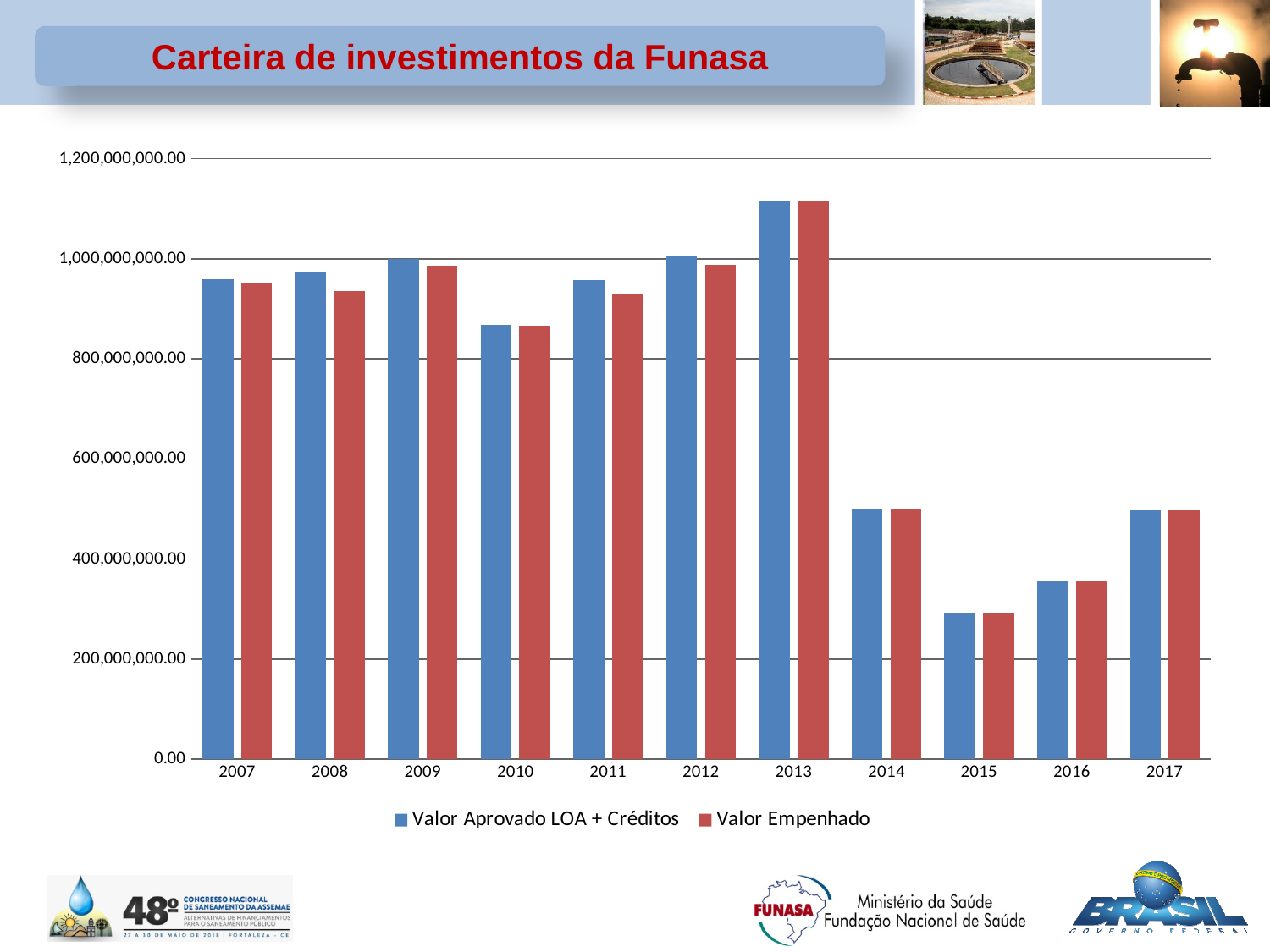
Is the Valor Aprovado LOA + Créditos for 2015 greater or less than 400,000,000.00? less Which year has the highest Valor Empenhado? 2013 Do the Valor Empenhado values rise or fall from 2013 to 2015? fall Which year has the lowest Valor Aprovado LOA + Créditos? 2015 Is the Valor Aprovado LOA + Créditos for 2014 greater or less than 400,000,000.00? greater How many series does the chart legend list? 2 Is the Valor Empenhado for 2013 greater or less than 1,000,000,000.00? greater In 2008, which is larger: Valor Aprovado LOA + Créditos or Valor Empenhado? Valor Aprovado LOA + Créditos What kind of chart is shown on the slide? bar chart How many years are shown on the x axis of the chart? 11 What colour are the Valor Empenhado bars in the chart? red